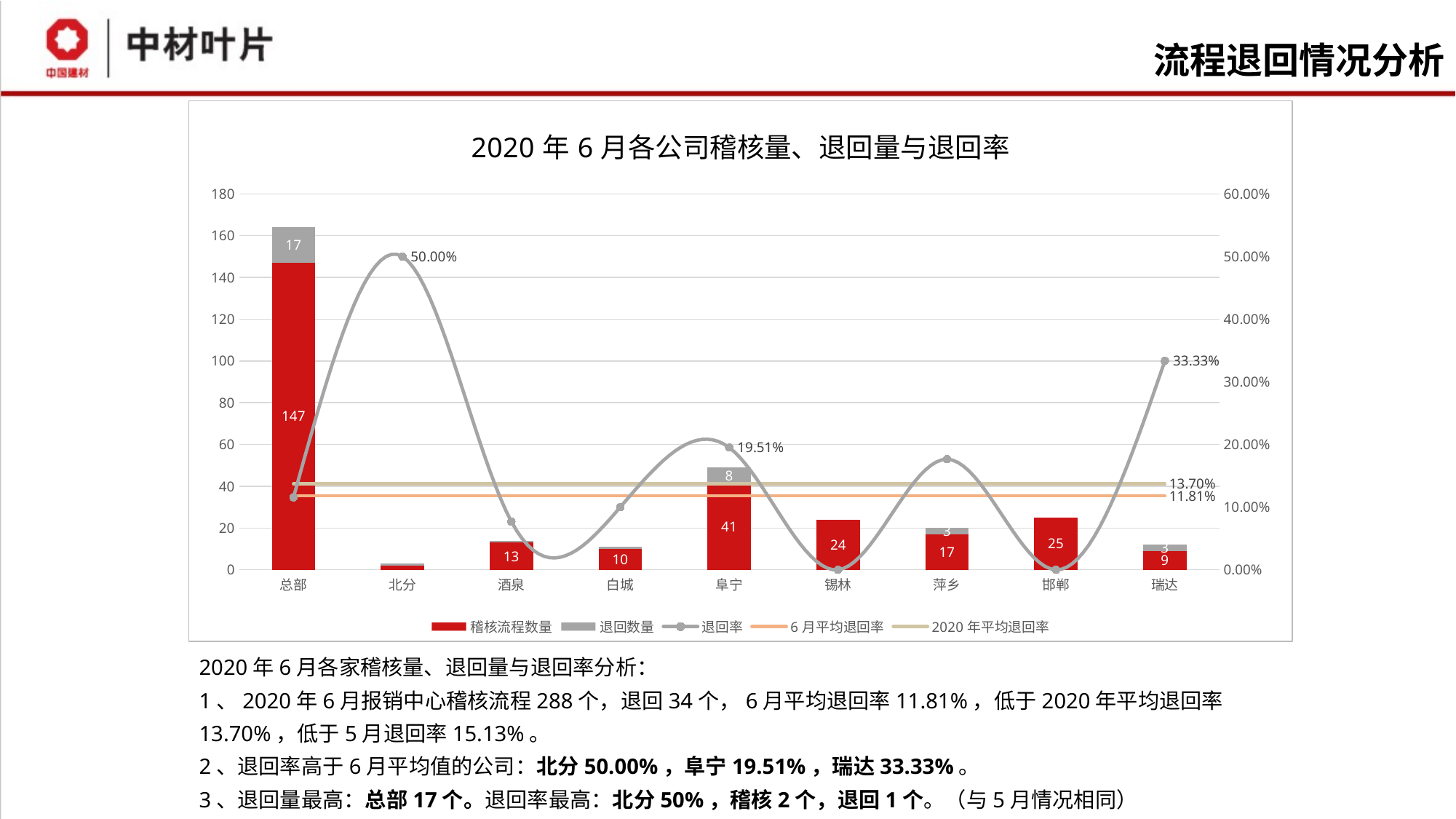
How many companies are shown on the x axis? 9 What is the title of the chart? 2020年6月各公司稽核量、退回量与退回率 Which company has the highest 稽核流程数量? 总部 What is the 退回数量 value for 阜宁? 8 Which has a larger 稽核流程数量, 酒泉 or 白城? 酒泉 What is the difference in 稽核流程数量 between 邯郸 and 锡林? 1 What is the 稽核流程数量 value for 总部? 147 What is the 退回率 value shown for 北分? 50.00% What is the total of the stacked bar for 总部 (稽核流程数量 plus 退回数量)? 164 What is the 退回率 value shown for 瑞达? 33.33% What kind of chart is this? Combined stacked bar and line chart How many series does the legend list? 5